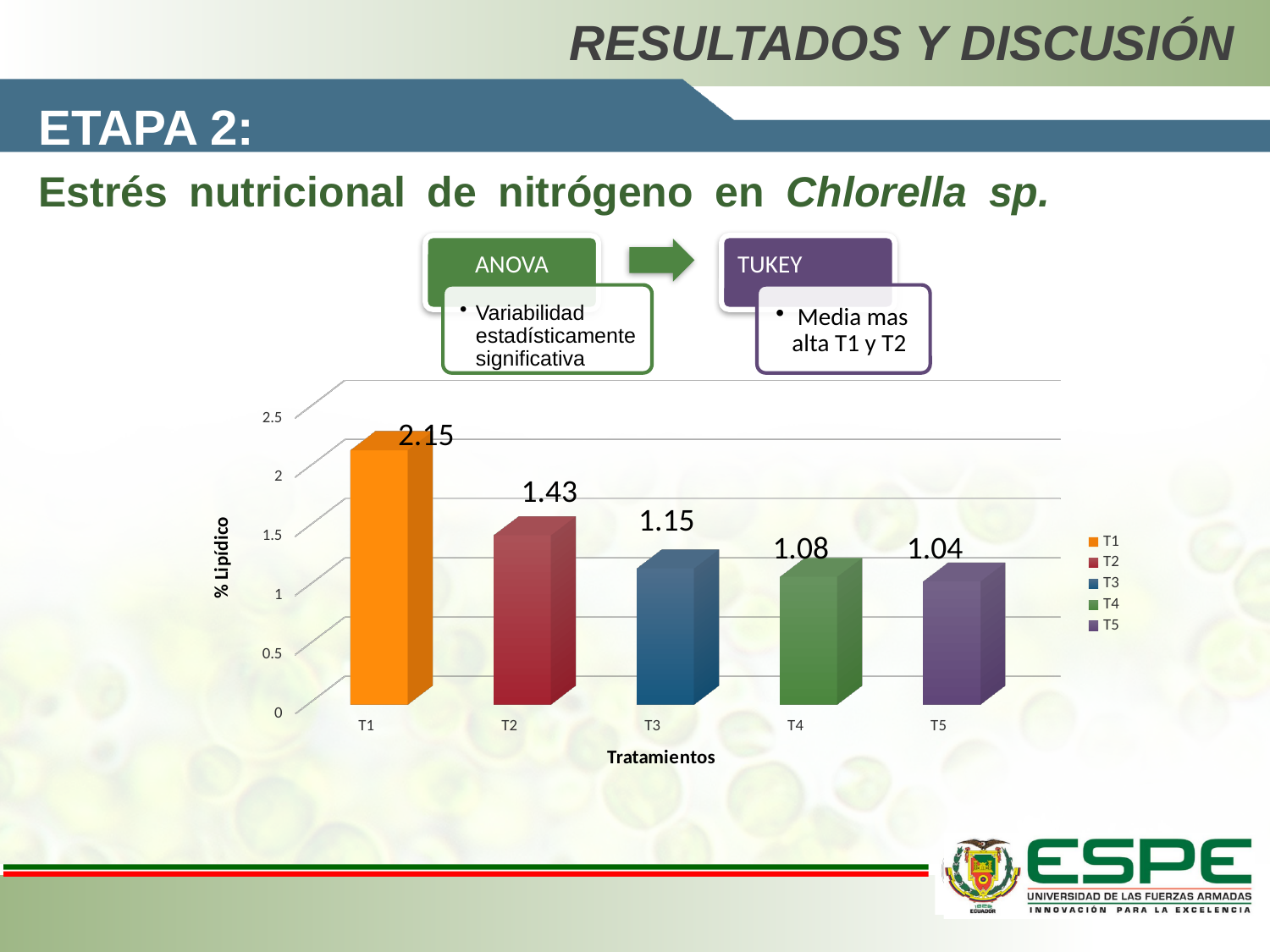
What is the % Lipídico value for treatment T1? 2.15 How many entries does the chart legend list? 5 Do the % Lipídico values rise or fall from T1 to T5? Fall Which has a higher % Lipídico, T2 or T4? T2 What is the difference in % Lipídico between T1 and T2? 0.72 Which treatment has the highest % Lipídico? T1 What is the difference in % Lipídico between T2 and T3? 0.28 What is the % Lipídico value for treatment T5? 1.04 Which treatment has the lowest % Lipídico? T5 What is the % Lipídico value for treatment T3? 1.15 What kind of chart is shown on the slide? Bar chart How many treatments are shown on the x axis of the chart? 5